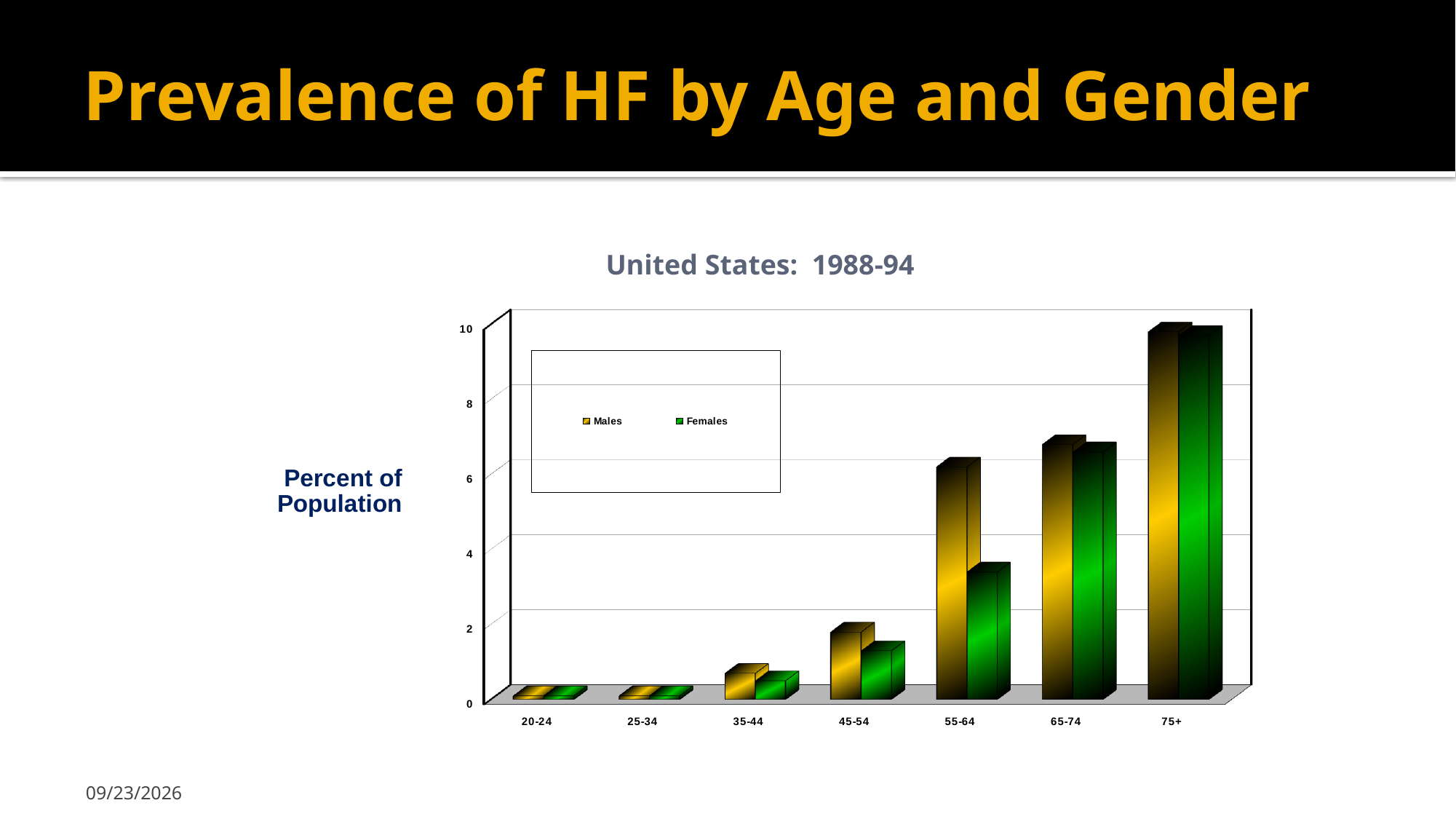
In the 55-64 age group, which is larger, the Males value or the Females value? Males Is the value for Males in the 55-64 age group greater or less than 4? greater What is the label on the vertical axis of the chart? Percent of Population What kind of chart is shown on the slide? Bar chart Is the value for Females in the 45-54 age group greater or less than 2? less How many age groups are shown on the x axis of the chart? 7 In the 45-54 age group, which is larger, the Males value or the Females value? Males Is the value for Males in the 75+ age group greater or less than 8? greater Do the Males values rise or fall as age increases along the x axis? Rise How many series does the chart's legend list? 2 Which age group has the highest value for Males? 75+